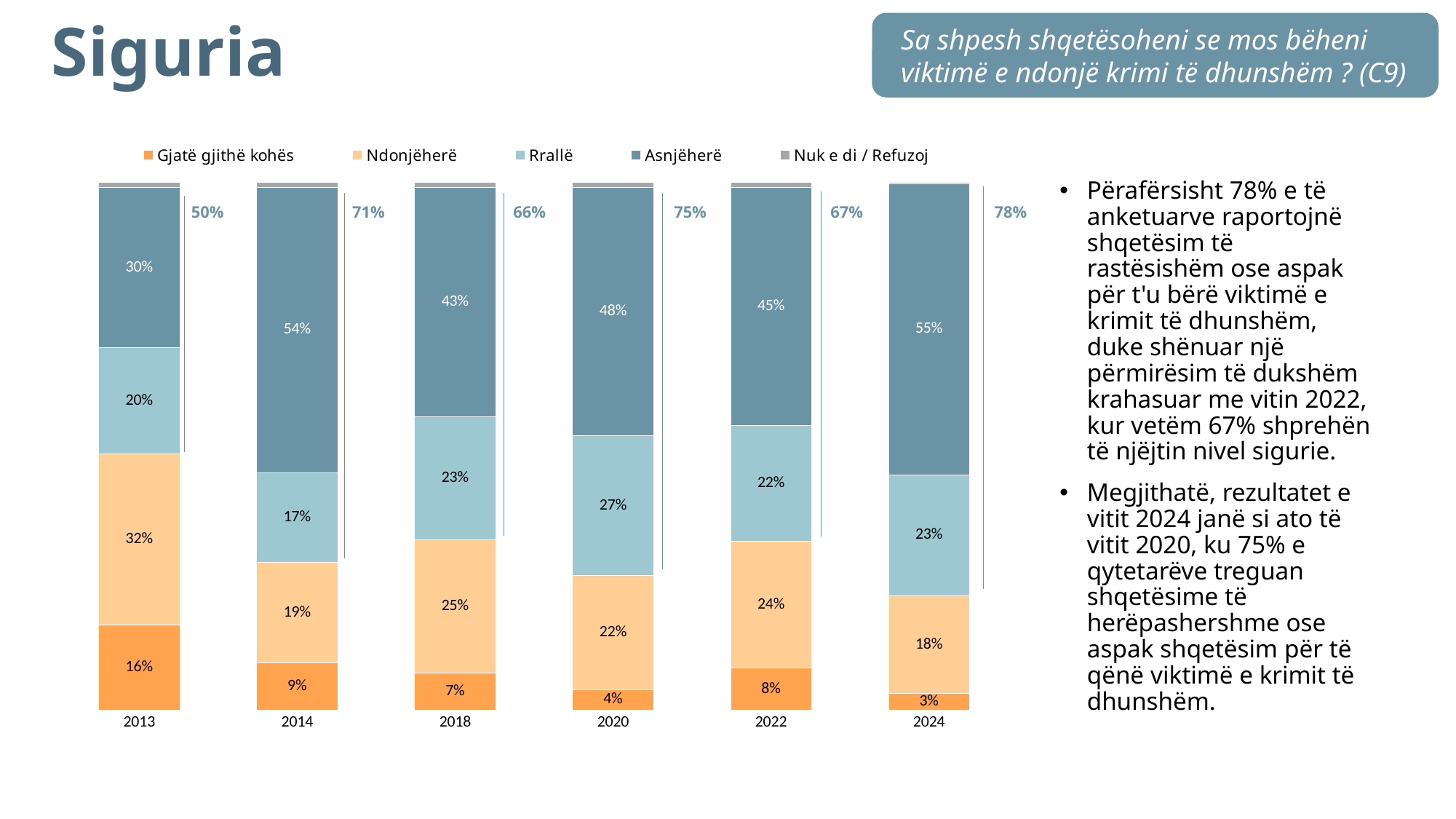
In which year is the Asnjëherë value highest? 2024 How many series does the legend list? 5 What is the value for Ndonjëherë in 2022? 24% What is the value for Gjatë gjithë kohës in 2013? 16% What is the difference between the Asnjëherë values for 2024 and 2022? 10% What is the value for Rrallë in 2020? 27% How many years are shown on the x axis? 6 Which is larger, the Ndonjëherë value in 2013 or in 2018? 2013 In which year is the Gjatë gjithë kohës value lowest? 2024 What is the value for Asnjëherë in 2024? 55% What combined percentage is labelled beside the 2020 bar? 75% What kind of chart is shown on the slide? stacked bar chart